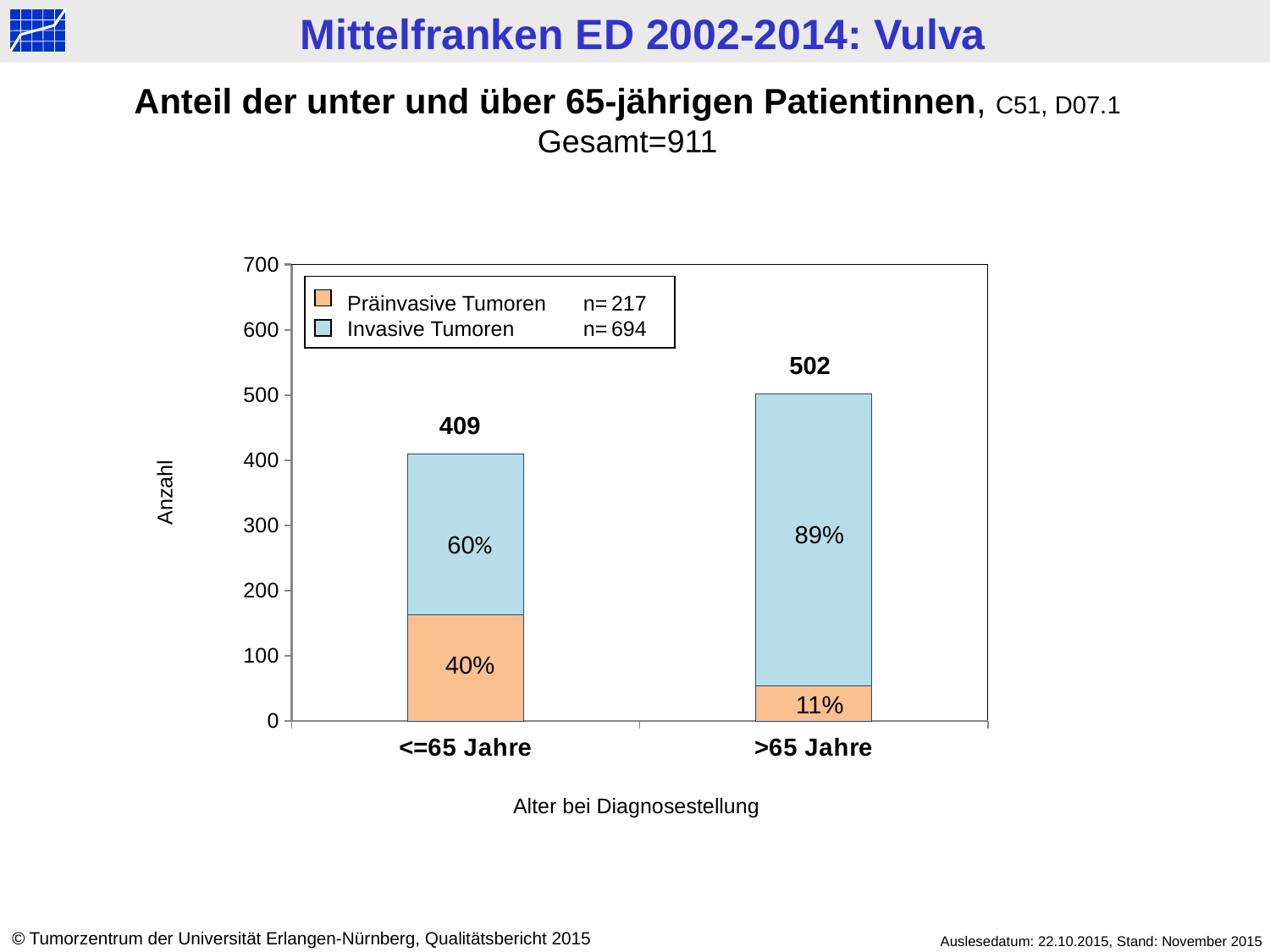
Is the Präinvasive Tumoren value for >65 Jahre greater or less than 100? less Is the Präinvasive Tumoren value for <=65 Jahre greater or less than 100? greater Which age group has the higher total number of patients? >65 Jahre What percentage of the >65 Jahre bar is Invasive Tumoren? 89% What is the total number of patients shown for the >65 Jahre bar? 502 What type of chart is shown on the slide? Stacked bar chart What percentage of the <=65 Jahre bar is Präinvasive Tumoren? 40% According to the legend, what is n for Invasive Tumoren? 694 What is the total number of patients shown for the <=65 Jahre bar? 409 What is the difference between the totals of the >65 Jahre and <=65 Jahre bars? 93 What percentage of the >65 Jahre bar is Präinvasive Tumoren? 11% How many series does the legend list? 2